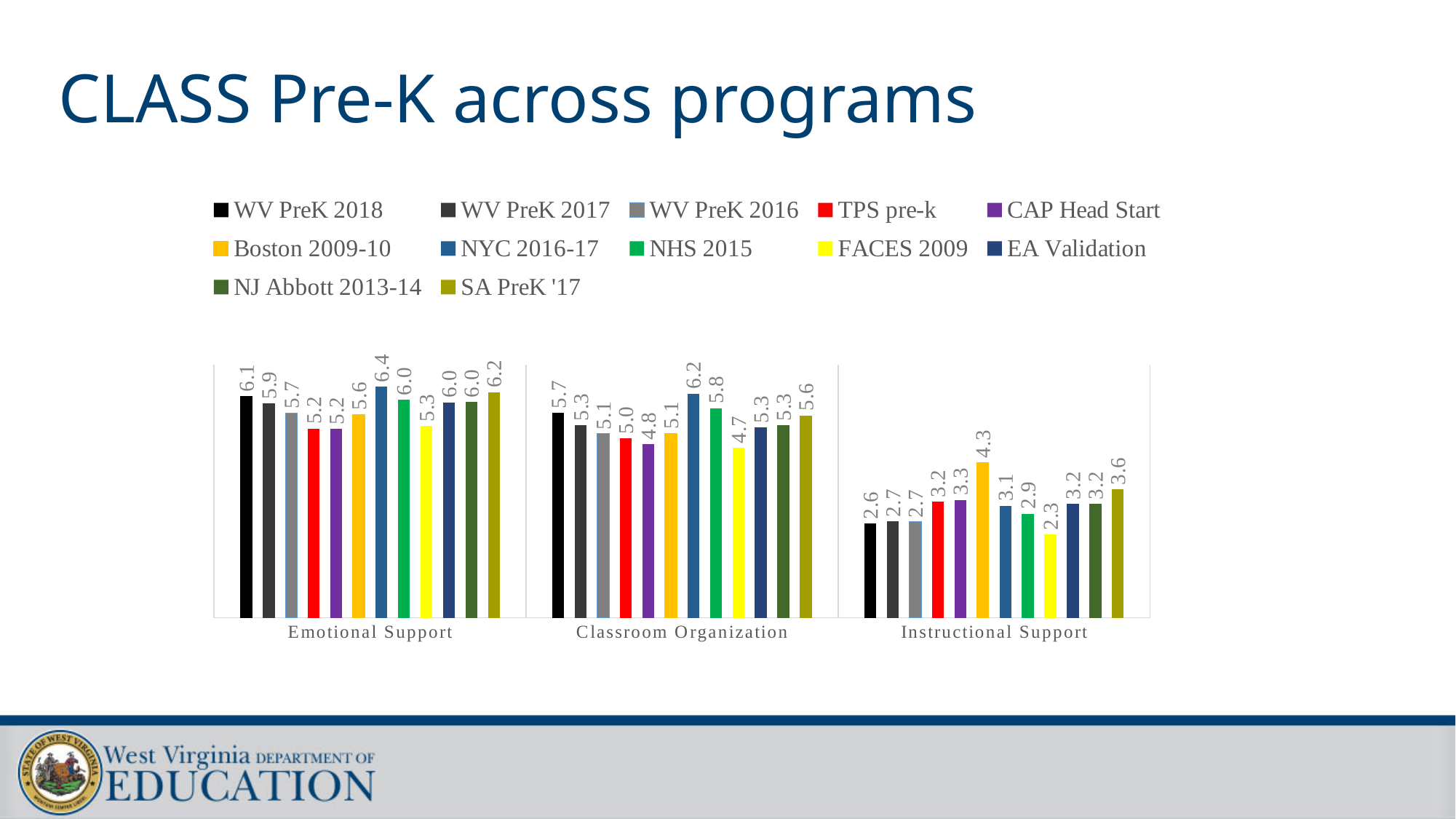
What is the difference between the Instructional Support values for Boston 2009-10 and WV PreK 2018? 1.7 What is the Emotional Support value for WV PreK 2018? 6.1 Which program has the highest Emotional Support value? NYC 2016-17 What is the Classroom Organization value for FACES 2009? 4.7 What kind of chart is shown on the slide? Bar chart Which is larger for Classroom Organization: NHS 2015 or SA PreK '17? NHS 2015 Which program has the highest Classroom Organization value? NYC 2016-17 Which program has the lowest Instructional Support value? FACES 2009 What is the title of the slide containing the chart? CLASS Pre-K across programs How many categories are shown on the x axis? 3 What is the Instructional Support value for Boston 2009-10? 4.3 How many series does the legend list? 12